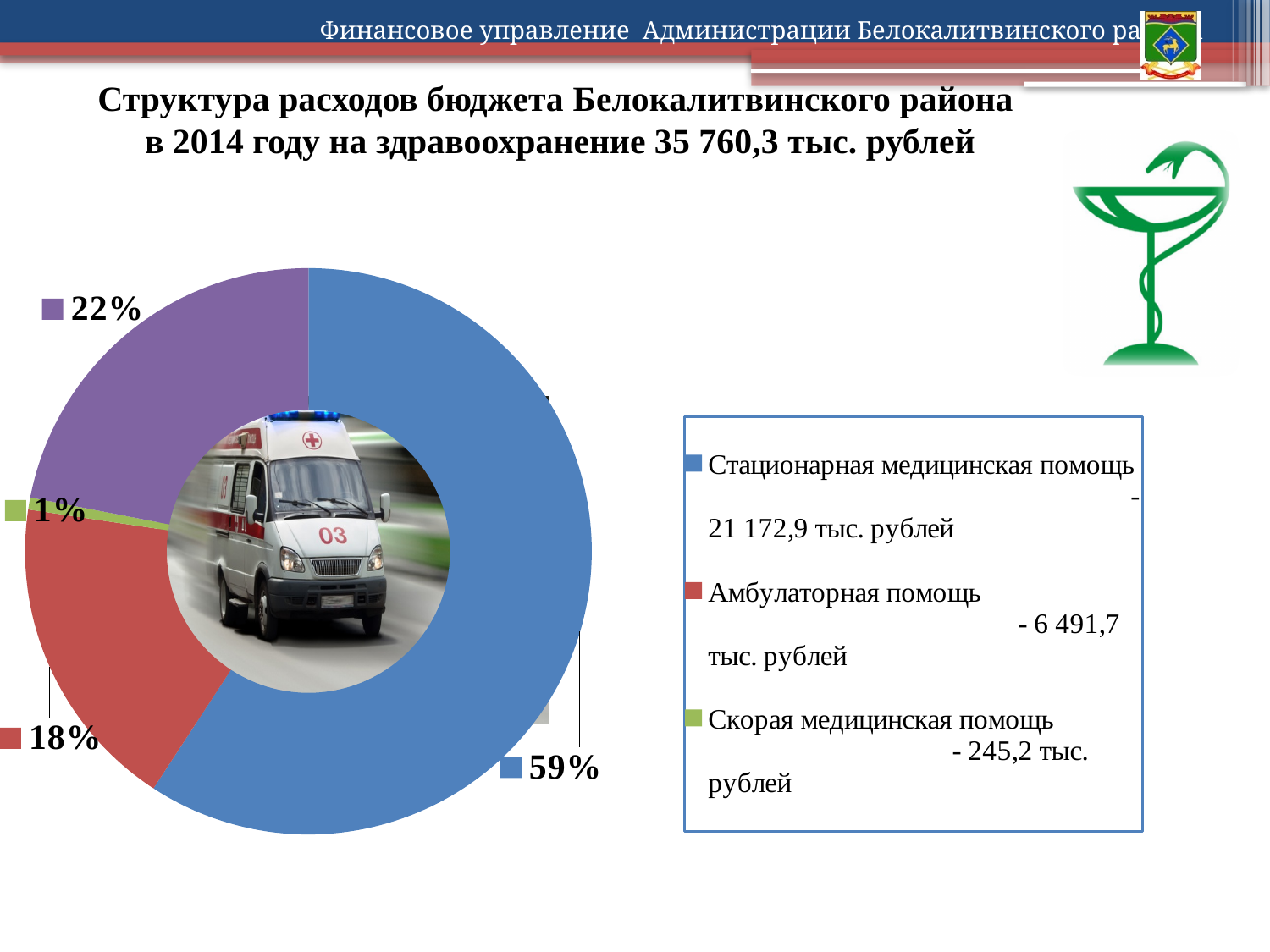
How many entries does the legend list? 3 What percentage of the pie chart does Амбулаторная помощь account for? 18% Which category has the largest slice of the pie chart? Стационарная медицинская помощь According to the legend, what amount is given for Стационарная медицинская помощь? 21 172,9 тыс. рублей According to the legend, what amount is given for Скорая медицинская помощь? 245,2 тыс. рублей By how many percentage points does the share of Стационарная медицинская помощь exceed the share of Амбулаторная помощь? 41 percentage points Which category has the smallest slice of the pie chart? Скорая медицинская помощь What kind of chart is shown on the slide? Doughnut chart What percentage of the pie chart does Скорая медицинская помощь account for? 1% Which slice is larger: Амбулаторная помощь or Скорая медицинская помощь? Амбулаторная помощь What percentage of the pie chart does Стационарная медицинская помощь account for? 59% How many slices does the pie chart have? 4